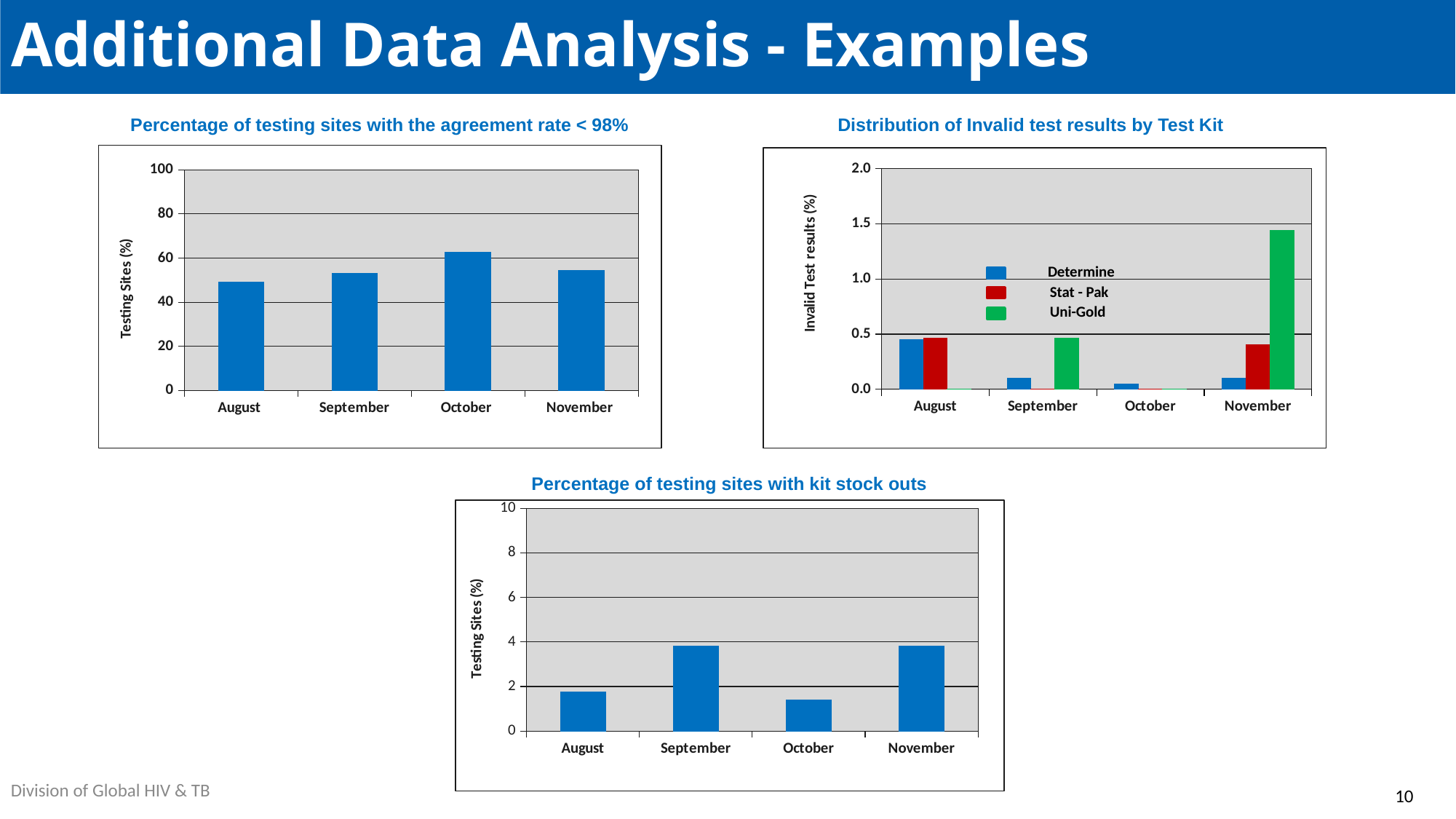
In the chart titled 'Percentage of testing sites with the agreement rate < 98%', is the value for August greater or less than 60? less In the chart titled 'Percentage of testing sites with the agreement rate < 98%', how many months are shown on the x axis? 4 In the chart titled 'Distribution of Invalid test results by Test Kit', is the Uni-Gold value for November greater or less than 1.0? greater In the chart titled 'Percentage of testing sites with kit stock outs', is the value for October greater or less than 2? less In the chart titled 'Distribution of Invalid test results by Test Kit', how many series does the legend list? 3 What kind of chart is 'Percentage of testing sites with kit stock outs'? Bar chart In the chart titled 'Percentage of testing sites with the agreement rate < 98%', which month has the highest value? October In the chart titled 'Distribution of Invalid test results by Test Kit', which colour represents Stat - Pak in the legend? Red In the chart titled 'Distribution of Invalid test results by Test Kit', which test kit has the tallest bar in November? Uni-Gold In the chart titled 'Percentage of testing sites with kit stock outs', which month has the lowest value? October